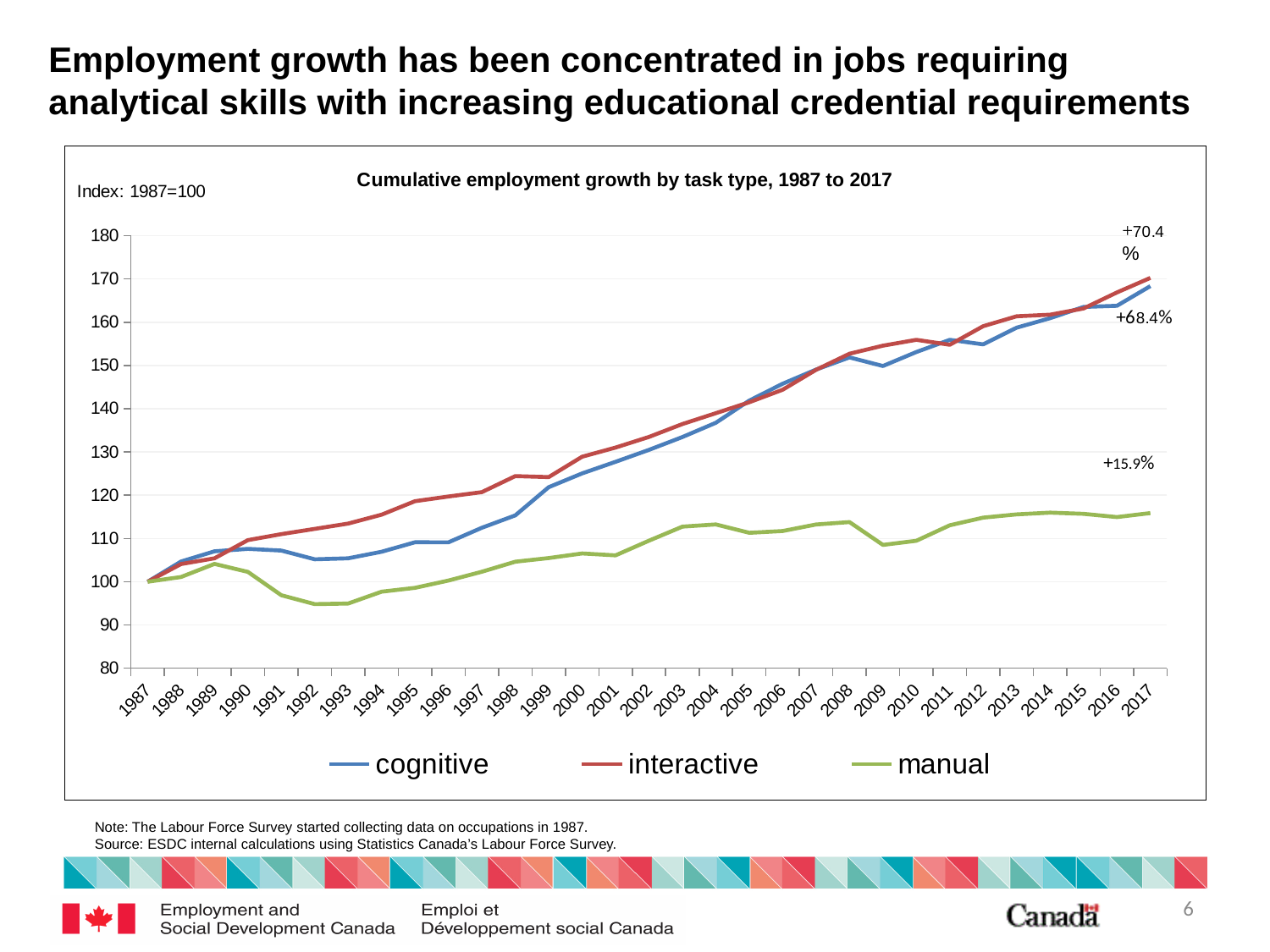
What is the title of the chart? Cumulative employment growth by task type, 1987 to 2017 Which series has the lowest index value in 2017? manual How many series does the legend list? 3 What is the difference in percentage points between the labelled 2017 growth of the interactive series and the cognitive series? 2.0 percentage points Is the value for the manual series in 2017 greater or less than 120? less Which series does the +70.4% label at the end of the chart refer to? interactive What cumulative growth is labelled for the cognitive series in 2017? +68.4% What cumulative growth is labelled for the manual series in 2017? +15.9% Does the manual series rise or fall between 1989 and 1992? fall Is the value for the cognitive series in 2008 greater or less than 140? greater Which series has the highest index value in 2017? interactive What type of chart is shown on the slide? Line chart